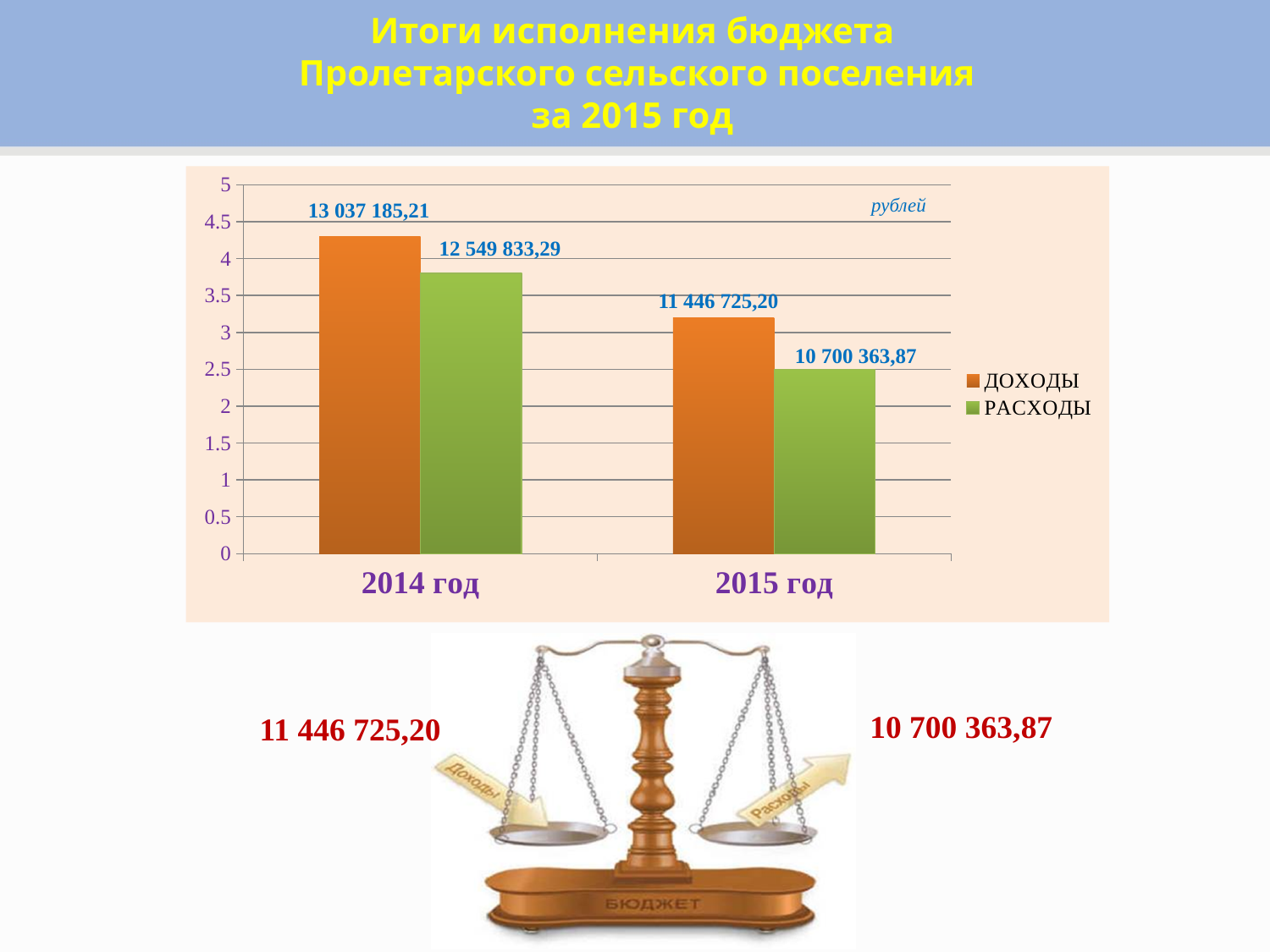
Which year has the lower value of РАСХОДЫ? 2015 год What is the value of ДОХОДЫ for 2015 год? 11 446 725,20 How many series does the chart legend list? 2 What is the value of ДОХОДЫ for 2014 год? 13 037 185,21 Do the ДОХОДЫ values rise or fall from 2014 год to 2015 год? fall In 2015 год, which is larger: ДОХОДЫ or РАСХОДЫ? ДОХОДЫ What type of chart is shown on the slide? bar chart How many year categories are shown on the x axis of the chart? 2 What is the value of РАСХОДЫ for 2015 год? 10 700 363,87 What is the value of РАСХОДЫ for 2014 год? 12 549 833,29 Which year has the higher value of ДОХОДЫ? 2014 год What is the difference between ДОХОДЫ and РАСХОДЫ in 2015 год? 746 361,33